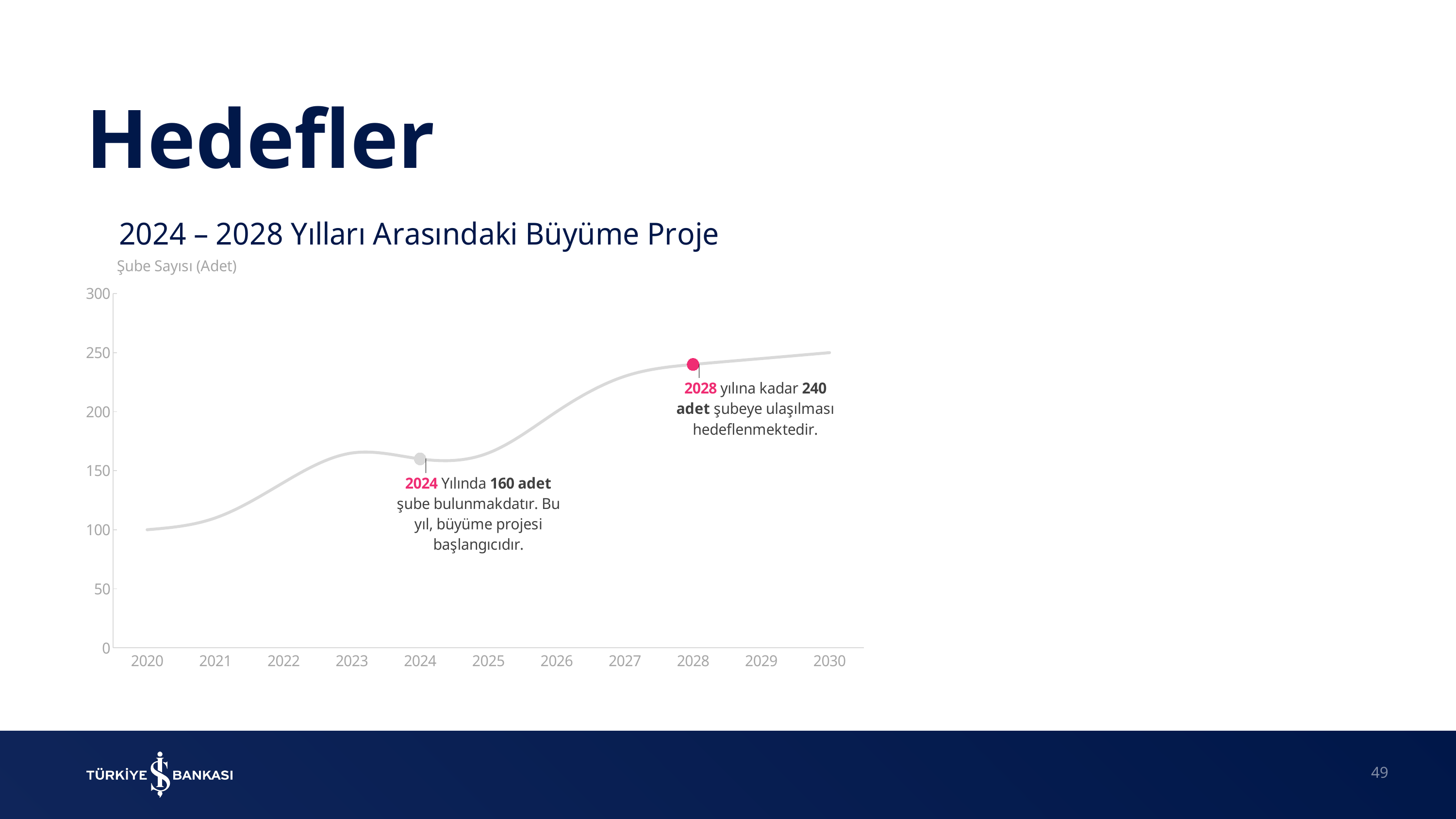
What kind of chart is shown on the slide? line chart Is the value for 2027 greater or less than 200? greater What is the label of the y axis of the chart? Şube Sayısı (Adet) What is the number of branches (şube sayısı) shown for 2024? 160 adet Is the value for 2021 greater or less than 150? less How many years are labelled on the x axis of the chart? 11 What is the target number of branches shown for 2028? 240 adet Which year has the larger labelled value, 2024 or 2028? 2028 Do the values generally rise or fall from 2020 to 2030? rise Is the value for 2022 greater or less than 150? less By how many branches is the 2028 target higher than the 2024 value? 80